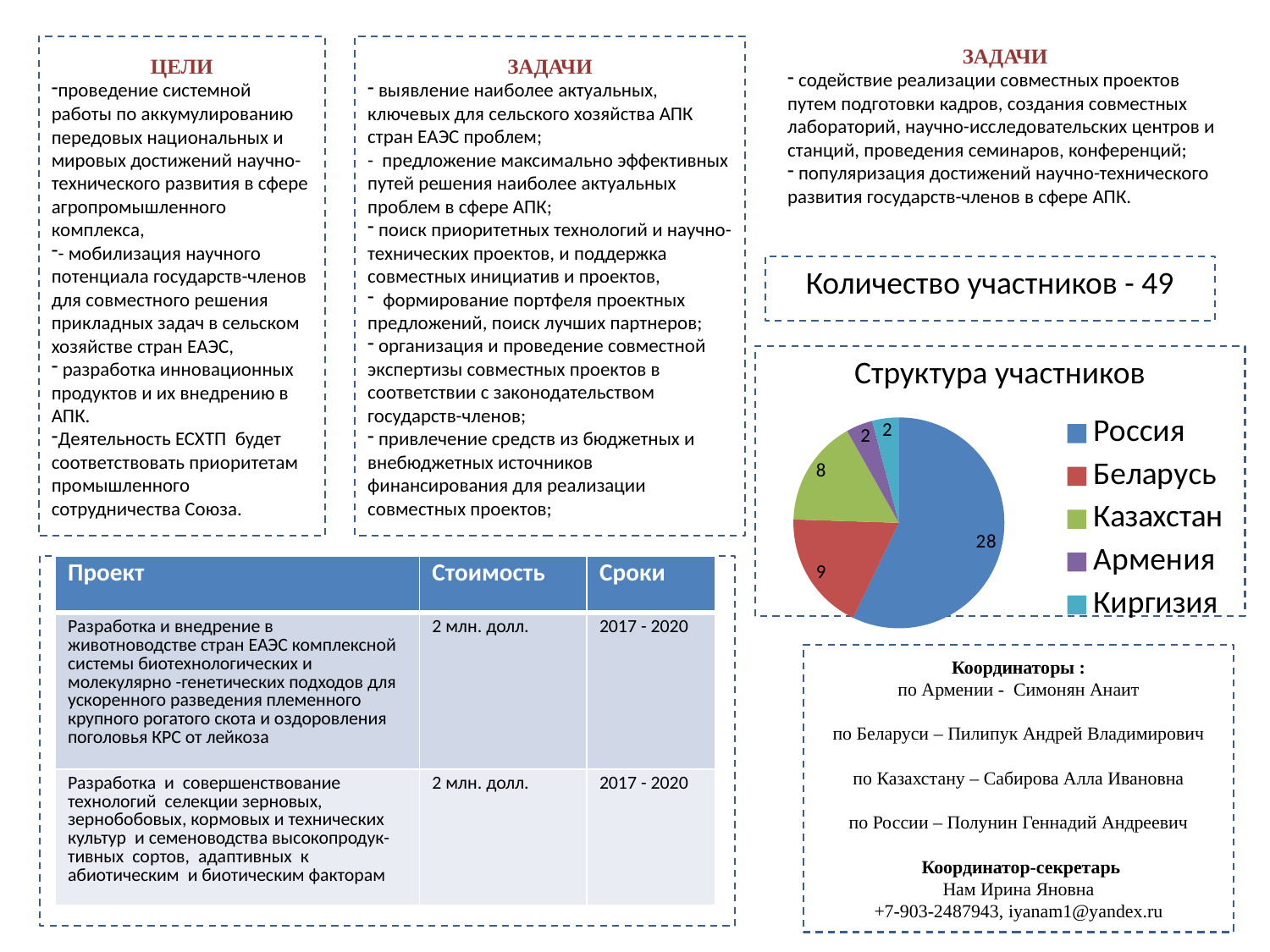
In the "Структура участников" chart, what is the difference between the values for Россия and Беларусь? 19 How many categories does the legend of the "Структура участников" chart list? 5 What is the title of the pie chart on the slide? Структура участников In the "Структура участников" chart, which is larger: the value for Беларусь or the value for Казахстан? Беларусь In the "Структура участников" chart, what colour is the slice for Казахстан? green In the "Структура участников" chart, what is the value for Россия? 28 In the "Структура участников" chart, what is the value for Армения? 2 In the "Структура участников" chart, what is the value for Беларусь? 9 In the "Структура участников" chart, what is the difference between the values for Казахстан and Киргизия? 6 In the "Структура участников" chart, what is the value for Казахстан? 8 What type of chart is shown under the title "Структура участников"? pie chart Which category has the largest slice in the "Структура участников" pie chart? Россия